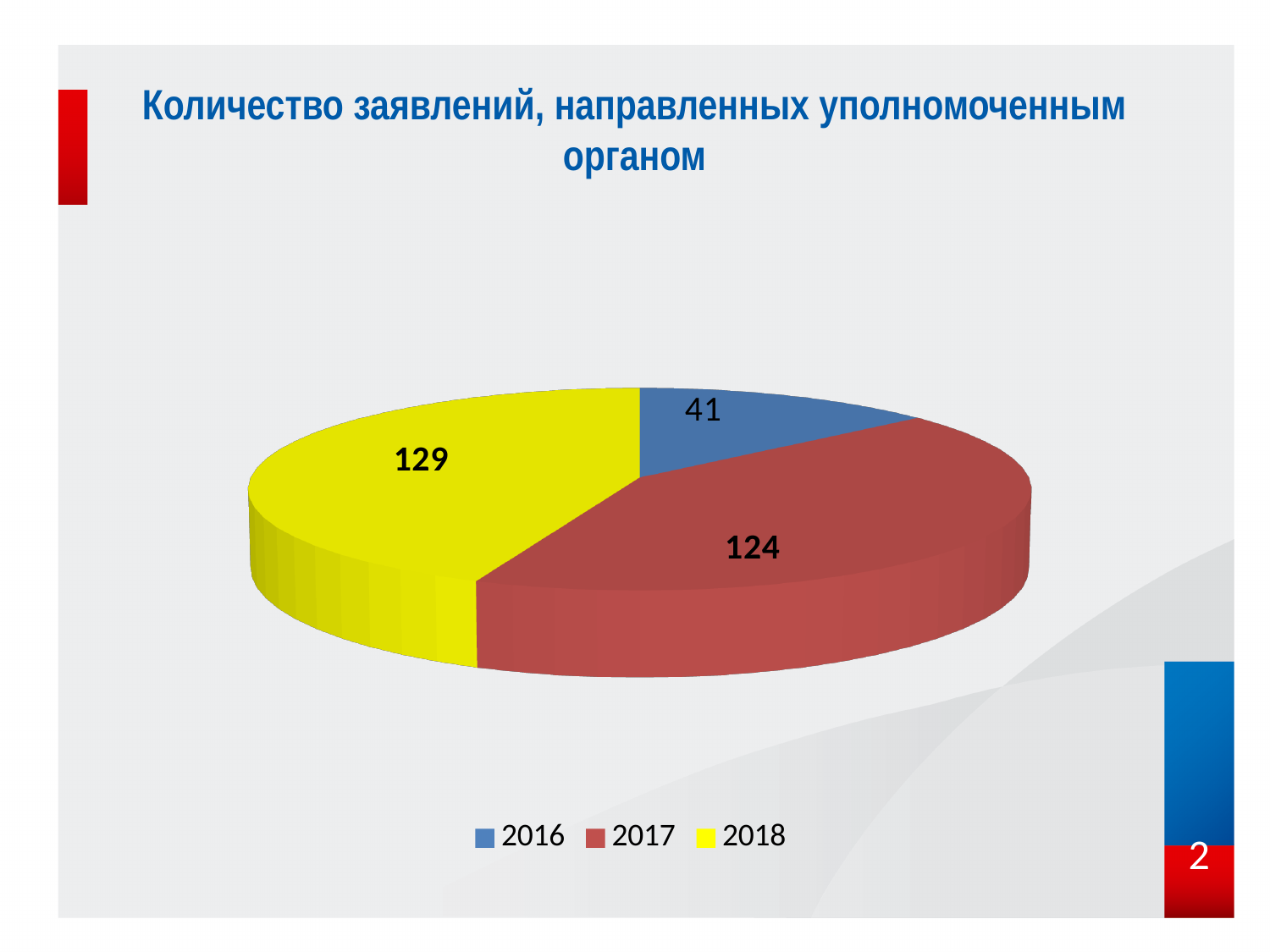
How many slices does the pie chart have? 3 Which year has the largest slice? 2018 How many entries does the legend list? 3 What is the difference between the values for 2017 and 2016? 83 What colour is the slice for 2018? yellow What is the value for 2016? 41 What type of chart is shown on the slide? pie chart Which is larger, the value for 2017 or the value for 2018? 2018 Which year has the smallest slice? 2016 What is the difference between the values for 2018 and 2017? 5 What is the value for 2017? 124 What is the value for 2018? 129